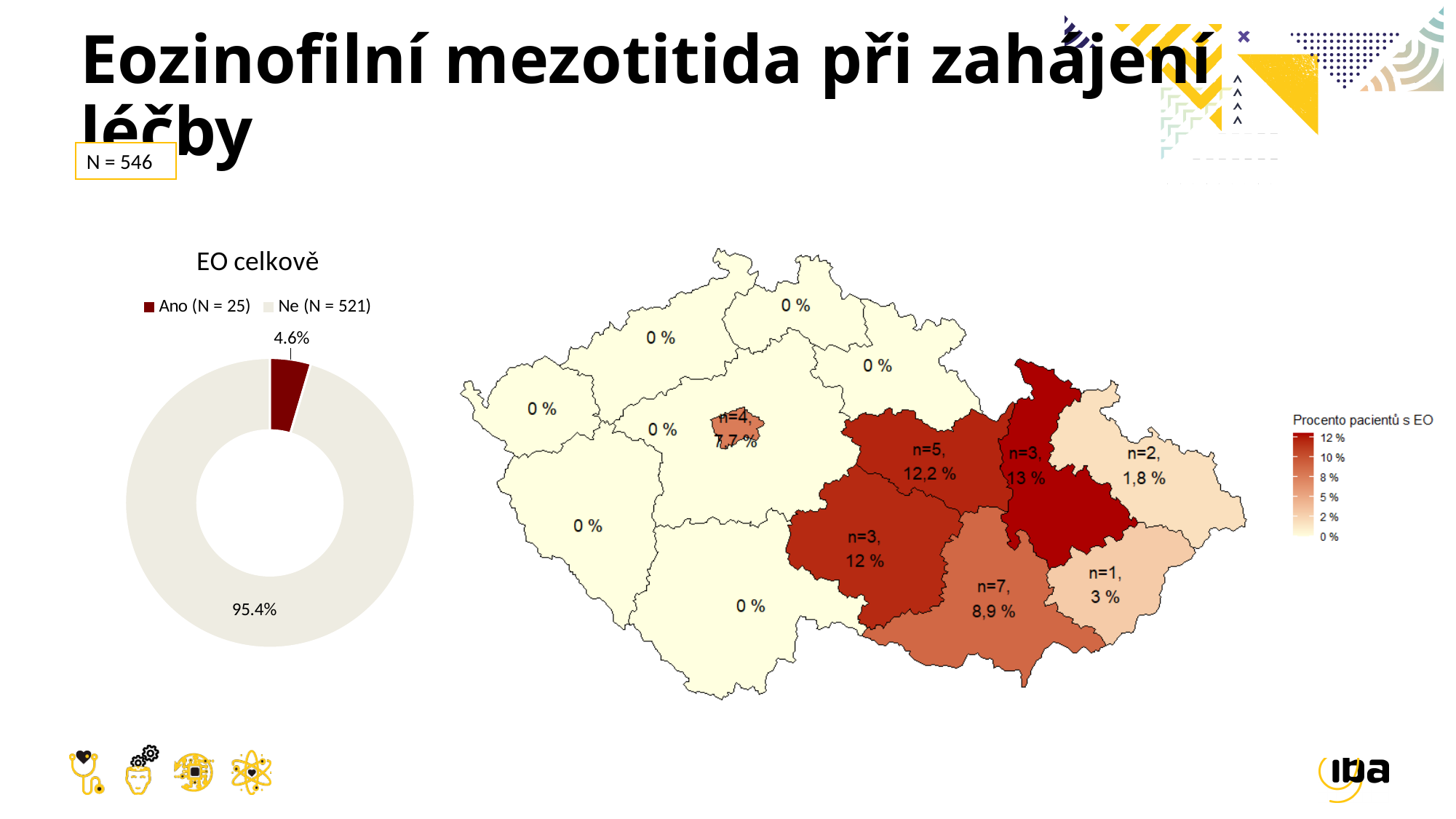
In the 'EO celkově' chart legend, what is the N given for 'Ano'? 25 What is the title of the colour legend next to the map chart? Procento pacientů s EO On the map chart, what is the highest percentage labelled for any region? 13 % In the 'EO celkově' chart legend, what is the N given for 'Ne'? 521 What kind of chart is the 'EO celkově' chart on the left? pie chart (donut) In the 'EO celkově' chart, what percentage is shown for 'Ano'? 4.6% What is the title of the chart on the left of the slide? EO celkově In the 'EO celkově' chart, what percentage is shown for 'Ne'? 95.4% In the 'EO celkově' chart, what is the difference between the 'Ne' and 'Ano' percentages? 90.8% On the map chart, what is the n value for the region labelled 8,9 %? n=7 How many categories does the legend of the 'EO celkově' chart list? 2 In the 'EO celkově' chart, which category has the larger share? Ne